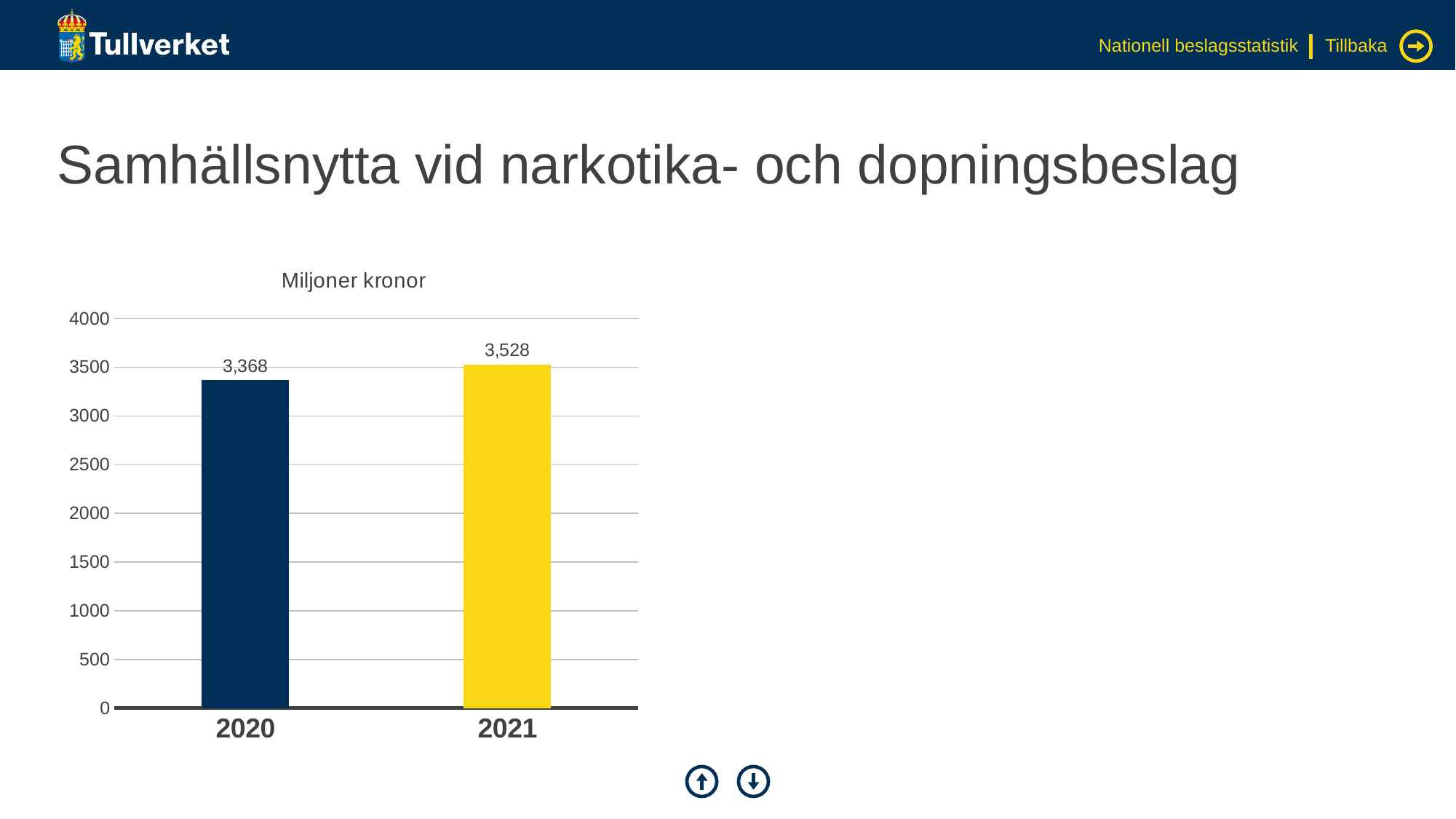
Which year has the lowest value? 2020 Is the value for 2020 greater or less than 3500? less How many years are shown on the chart? 2 What kind of chart is shown on the slide? bar chart Which year has the highest value? 2021 What is the difference between the values for 2021 and 2020? 160 Is the value for 2021 greater or less than 3500? greater What unit label is shown above the chart? Miljoner kronor What is the value for 2020? 3,368 What is the value for 2021? 3,528 Do the values rise or fall from 2020 to 2021? rise Which is larger, the value for 2020 or the value for 2021? 2021